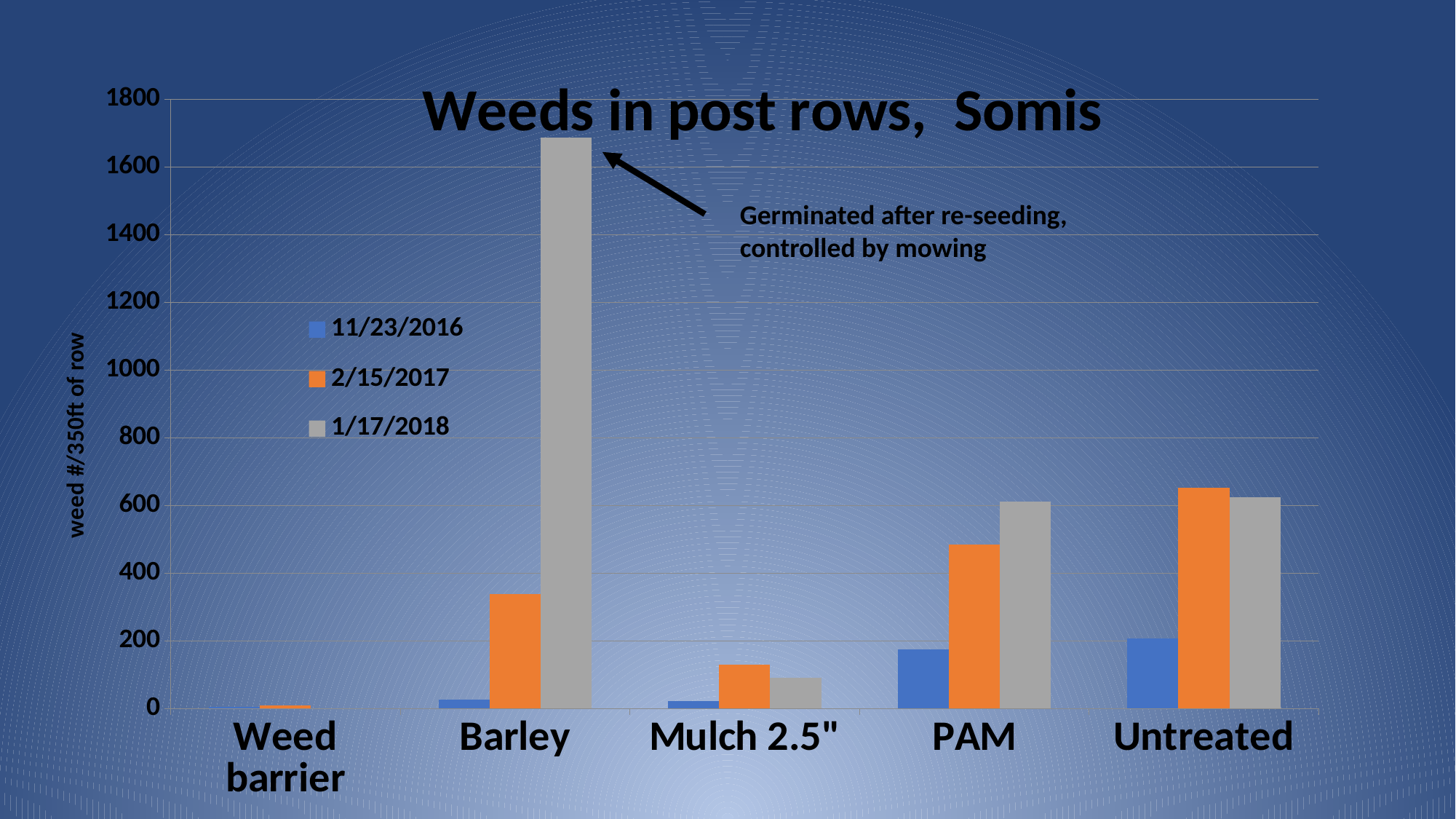
What is the label on the y axis? weed #/350ft of row Is the 1/17/2018 value for Barley greater or less than 1600? greater Which category has the highest value for the 2/15/2017 series? Untreated What kind of chart is shown on the slide? bar chart What is the title of the chart? Weeds in post rows, Somis Which category has the highest value for the 1/17/2018 series? Barley How many treatment categories are shown on the x axis? 5 How many series does the legend list? 3 Is the 2/15/2017 value for Mulch 2.5" greater or less than 200? less Is the 2/15/2017 value for PAM greater or less than 400? greater Which is larger for PAM: the 2/15/2017 value or the 1/17/2018 value? 1/17/2018